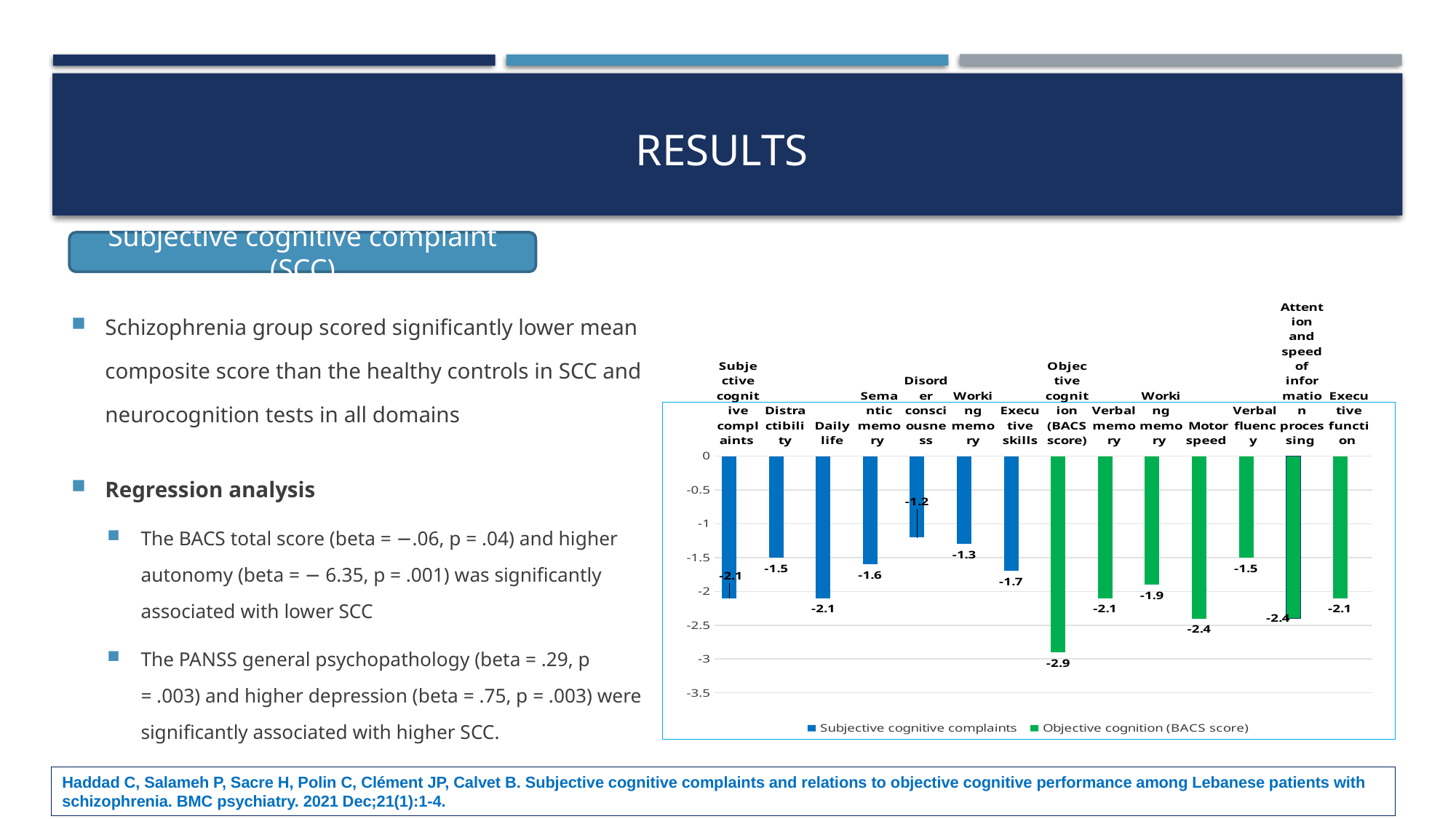
How many series does the legend list? 2 What is the value for Motor speed? -2.4 How many categories are plotted in the chart? 14 What is the difference between the values for Objective cognition (BACS score) and Verbal memory? 0.8 Which bar extends further below zero, Daily life or Semantic memory? Daily life What is the value for Distractibility? -1.5 What type of chart is shown? Bar chart What is the value for Executive skills? -1.7 Which category has the lowest (most negative) value? Objective cognition (BACS score) What is the value for Objective cognition (BACS score)? -2.9 What is the difference between the values for Motor speed and Verbal fluency? 0.9 Which category has the highest (least negative) value? Disorder consciousness